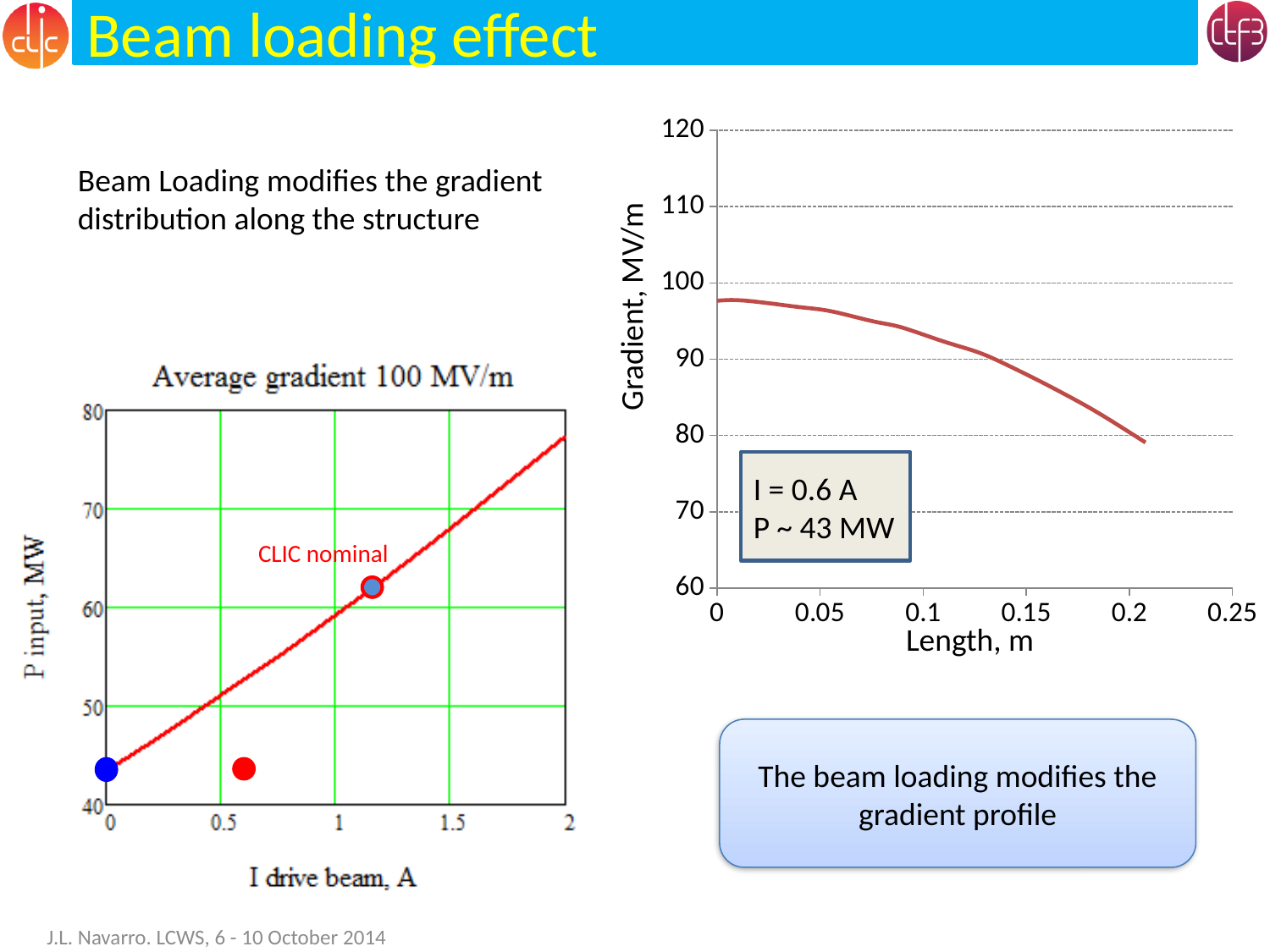
On the right-hand chart (Gradient vs Length), is the gradient at length 0.2 m greater or less than 90 MV/m? less What is the title of the left-hand chart? Average gradient 100 MV/m On the right-hand chart (Gradient vs Length), is the gradient at length 0.1 m greater or less than 90 MV/m? greater On the right-hand chart (Gradient vs Length), what is the label of the y axis? Gradient, MV/m On the left-hand chart (Average gradient 100 MV/m), is P input at I drive beam = 0 A greater or less than 50 MW? less On the left-hand chart (Average gradient 100 MV/m), does P input rise or fall as I drive beam increases? rise On the right-hand chart (Gradient vs Length), what is the highest value shown on the y axis? 120 On the right-hand chart (Gradient vs Length), does the gradient rise or fall as length increases? fall On the right-hand chart (Gradient vs Length), what is the label of the x axis? Length, m On the right-hand chart (Gradient vs Length), what beam current is stated in the annotation box? I = 0.6 A